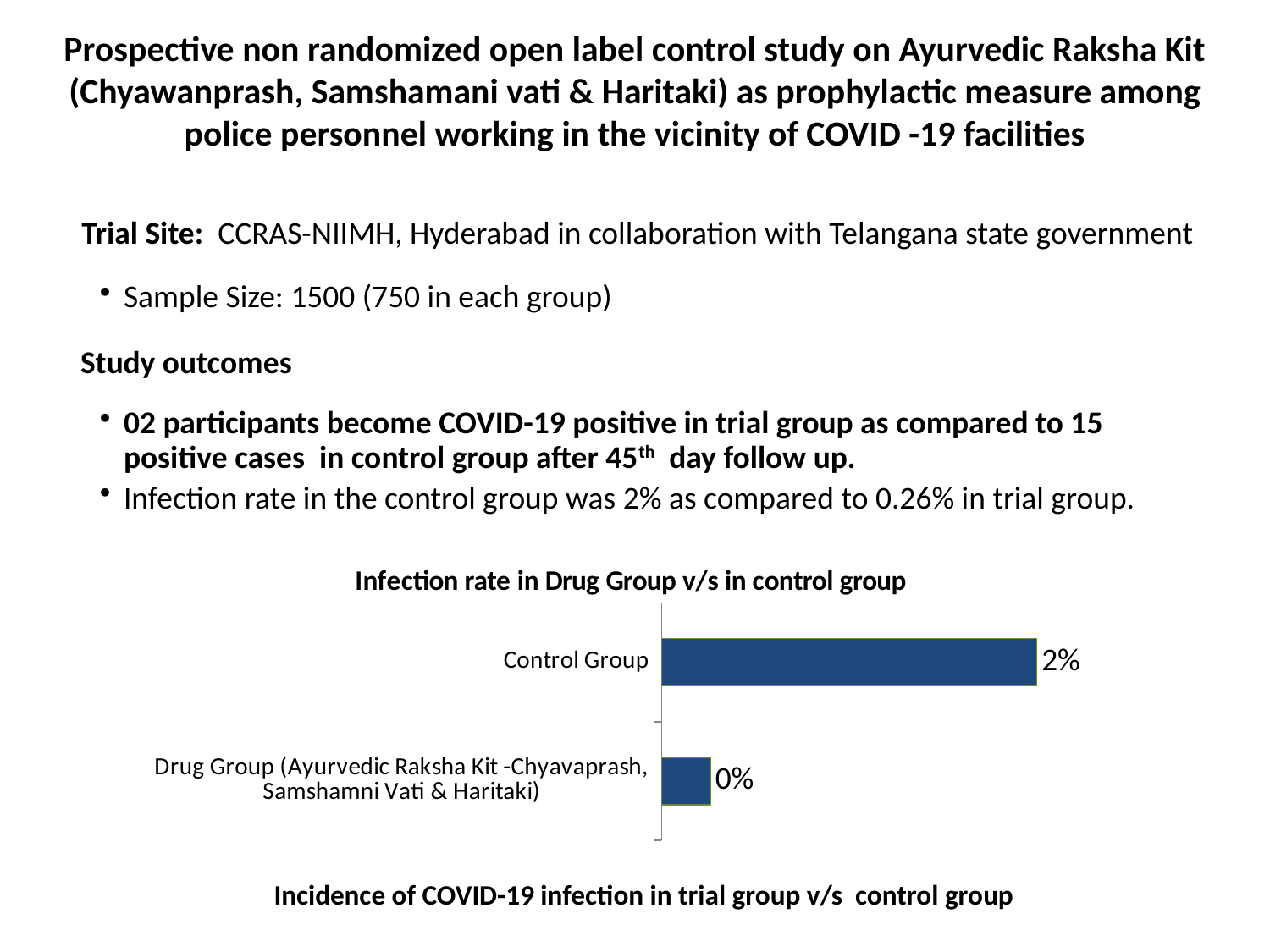
What is the infection rate shown for the Control Group in the chart? 2% Which group has the lowest infection rate in the chart? Drug Group (Ayurvedic Raksha Kit -Chyavaprash, Samshamni Vati & Haritaki) What is the title of the chart on the slide? Infection rate in Drug Group v/s in control group What type of chart is shown on the slide? Bar chart What is the infection rate shown for the Drug Group (Ayurvedic Raksha Kit -Chyavaprash, Samshamni Vati & Haritaki) in the chart? 0% What is the difference between the infection rate labels for the Control Group and the Drug Group in the chart? 2% What caption appears below the chart on the slide? Incidence of COVID-19 infection in trial group v/s control group Is the infection rate for the Control Group larger or smaller than that for the Drug Group? Larger Which group has the higher infection rate in the chart? Control Group How many categories (groups) are plotted in the chart? 2